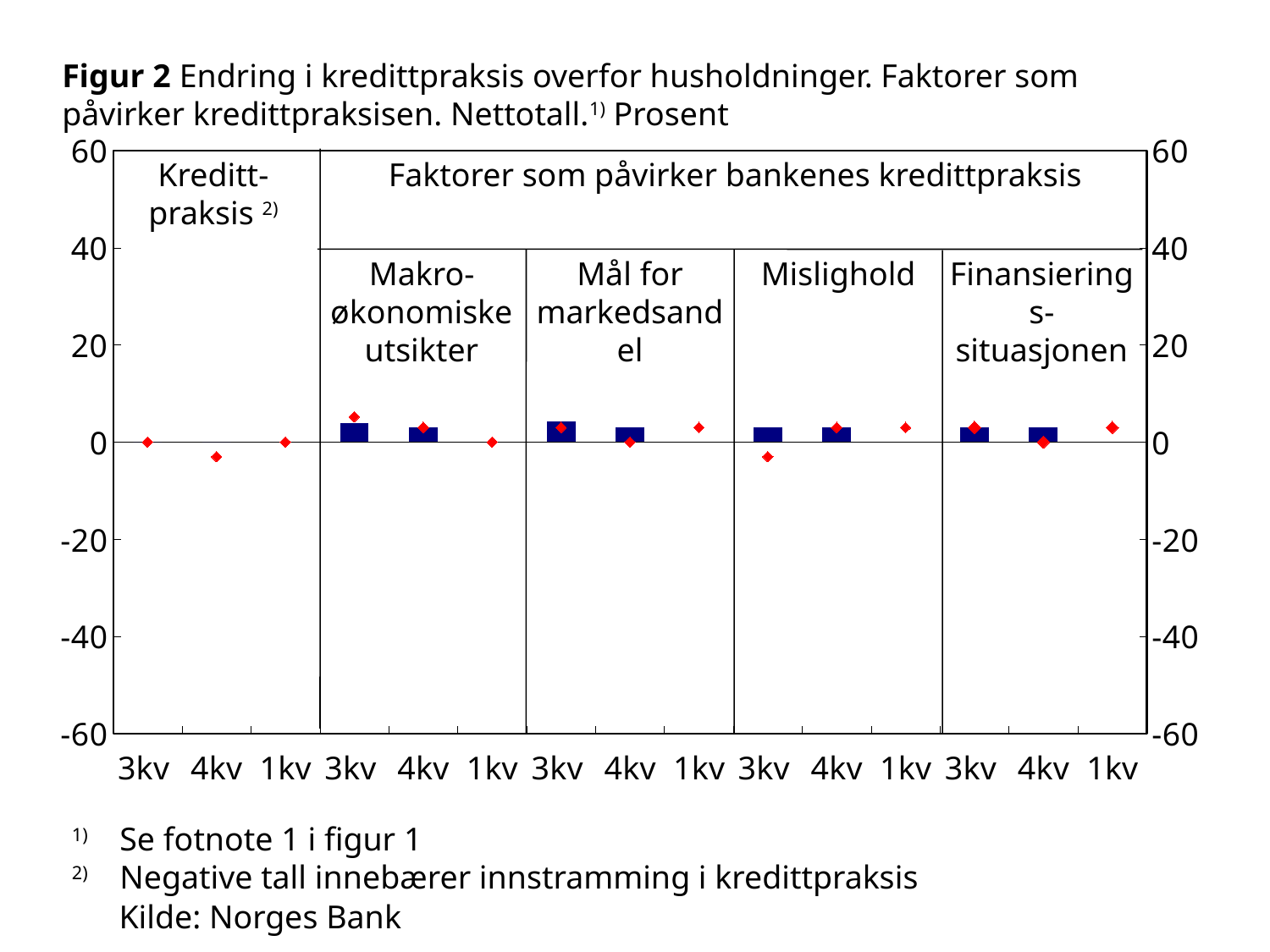
How many factor panels are grouped under the heading 'Faktorer som påvirker bankenes kredittpraksis'? 4 What is the highest value shown on the y axis? 60 What kind of chart is shown on the slide? combination chart (bars with diamond markers) What is the lowest value shown on the y axis? -60 Is the value for 1kv in the 'Finansieringssituasjonen' panel greater or less than 20? less Is the bar for 3kv in the 'Makro-økonomiske utsikter' panel greater or less than 20? less Is the value for 4kv in the 'Kredittpraksis' panel greater or less than -20? greater How many panels (sections) does the chart have along the x axis? 5 How many quarter labels (3kv, 4kv, 1kv) are shown along the x axis in total? 15